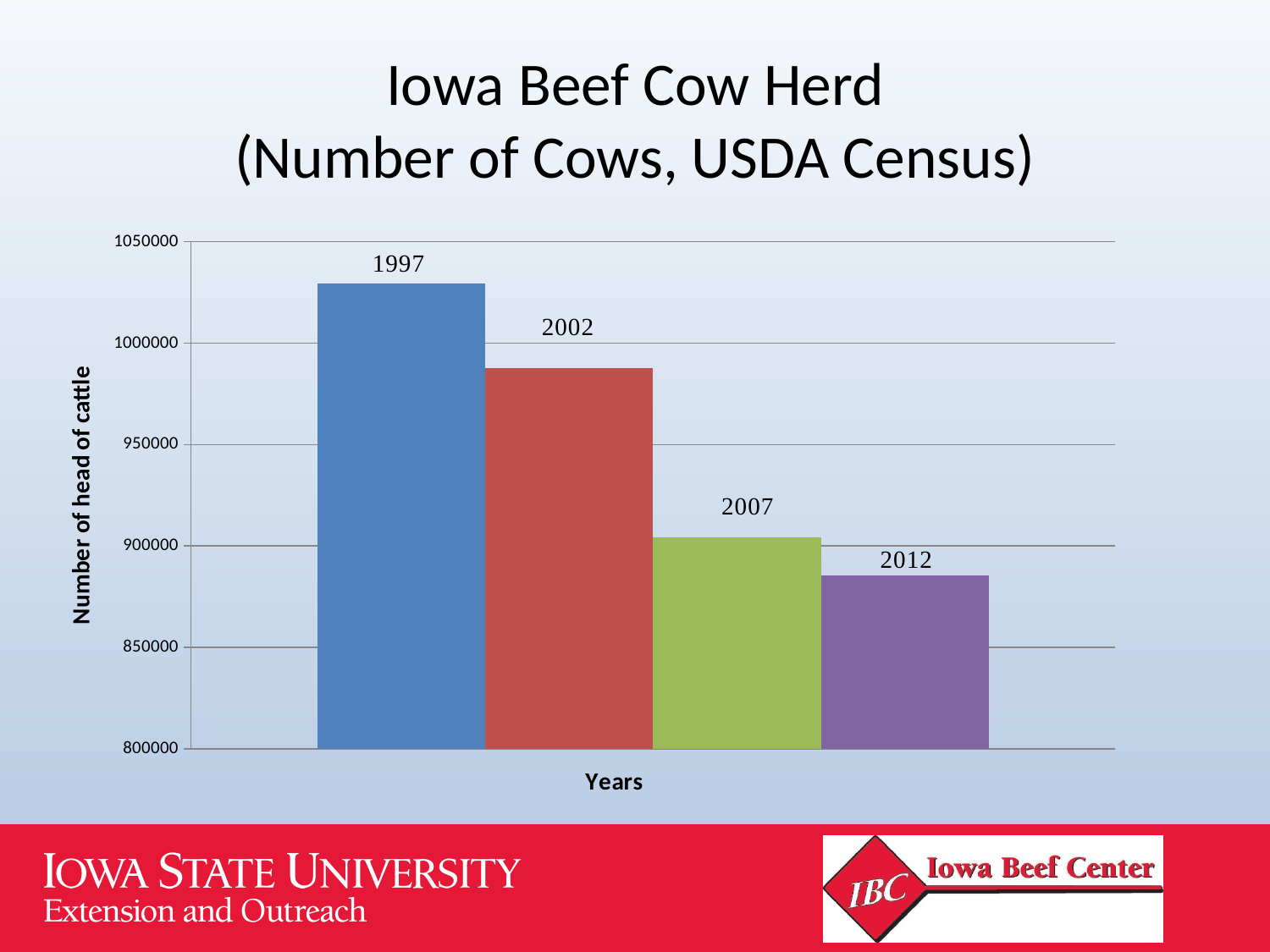
Is the value for 1997 greater or less than 1000000? greater Do the values rise or fall from 1997 to 2012? fall Which year has the highest number of beef cows? 1997 Is the value for 2012 greater or less than 900000? less What is the label on the vertical axis of the chart? Number of head of cattle Which year has the lowest number of beef cows? 2012 Is the value for 2007 greater or less than 950000? less Which is larger, the value for 2007 or the value for 2012? 2007 How many bars (census years) are plotted in the chart? 4 Which is larger, the value for 1997 or the value for 2002? 1997 What kind of chart is shown on the slide? bar chart